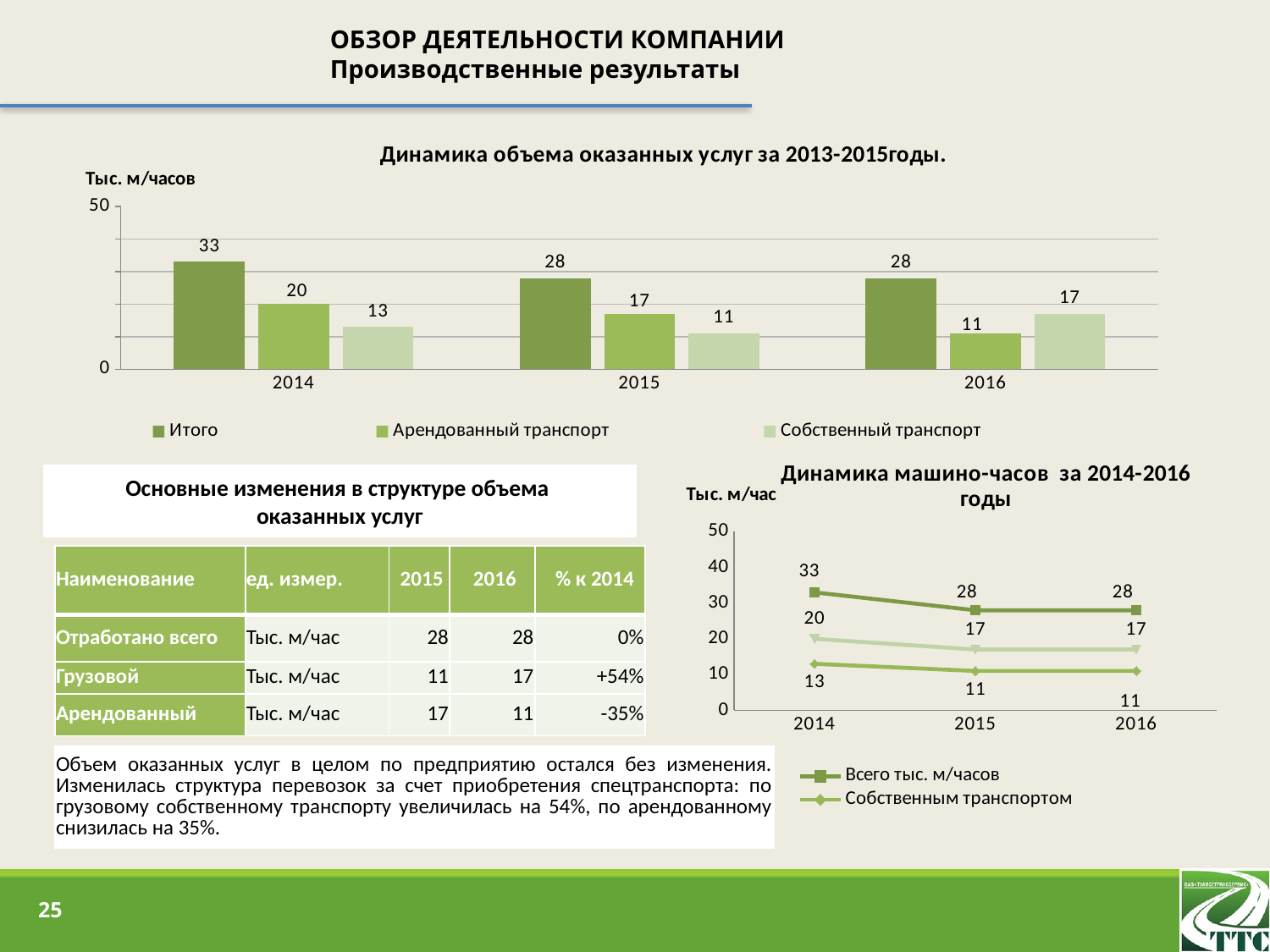
In the bottom-right line chart 'Динамика машино-часов за 2014-2016 годы', does the 'Всего тыс. м/часов' line rise or fall from 2014 to 2015? Fall In the top bar chart 'Динамика объема оказанных услуг за 2013-2015годы.', which is larger in 2016: 'Арендованный транспорт' or 'Собственный транспорт'? Собственный транспорт What kind of chart is the bottom-right chart 'Динамика машино-часов за 2014-2016 годы'? Line chart In the bottom-right line chart 'Динамика машино-часов за 2014-2016 годы', what is the value of 'Всего тыс. м/часов' for 2016? 28 In the top bar chart 'Динамика объема оказанных услуг за 2013-2015годы.', what is the difference between 'Итого' in 2014 and 'Итого' in 2015? 5 In the top bar chart 'Динамика объема оказанных услуг за 2013-2015годы.', what is the value of 'Арендованный транспорт' for 2016? 11 In the bottom-right line chart 'Динамика машино-часов за 2014-2016 годы', how many years are shown on the x axis? 3 What kind of chart is the top chart 'Динамика объема оказанных услуг за 2013-2015годы.'? Bar chart In the top bar chart 'Динамика объема оказанных услуг за 2013-2015годы.', in which year is 'Итого' highest? 2014 In the top bar chart 'Динамика объема оказанных услуг за 2013-2015годы.', what is the value of 'Собственный транспорт' for 2015? 11 In the top bar chart 'Динамика объема оказанных услуг за 2013-2015годы.', what is the value of 'Итого' for 2014? 33 In the top bar chart 'Динамика объема оказанных услуг за 2013-2015годы.', how many series does the legend list? 3